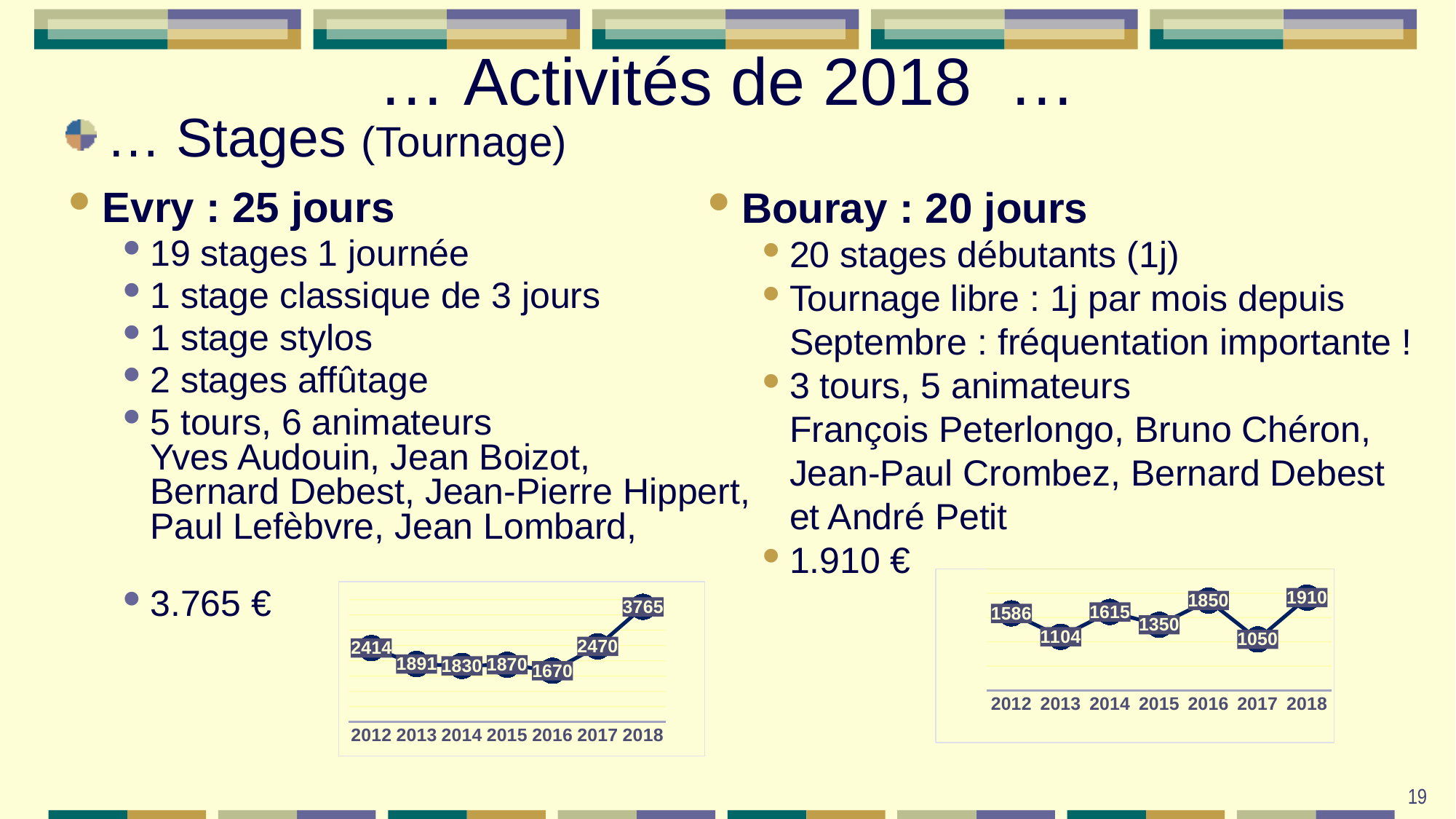
In the left chart, which year has the highest value? 2018 In the left chart, what is the value for 2012? 2414 In the left chart, which year has the lowest value? 2016 In the right chart, which is larger, the value for 2013 or the value for 2015? 2015 What kind of chart is the left chart? line chart In the left chart, what is the difference between the values for 2018 and 2017? 1295 In the right chart, what is the difference between the values for 2016 and 2017? 800 In the right chart, what is the value for 2017? 1050 In the right chart, what is the value for 2014? 1615 In the left chart, what is the value for 2018? 3765 In the right chart, which year has the highest value? 2018 How many data points are plotted in the left chart? 7